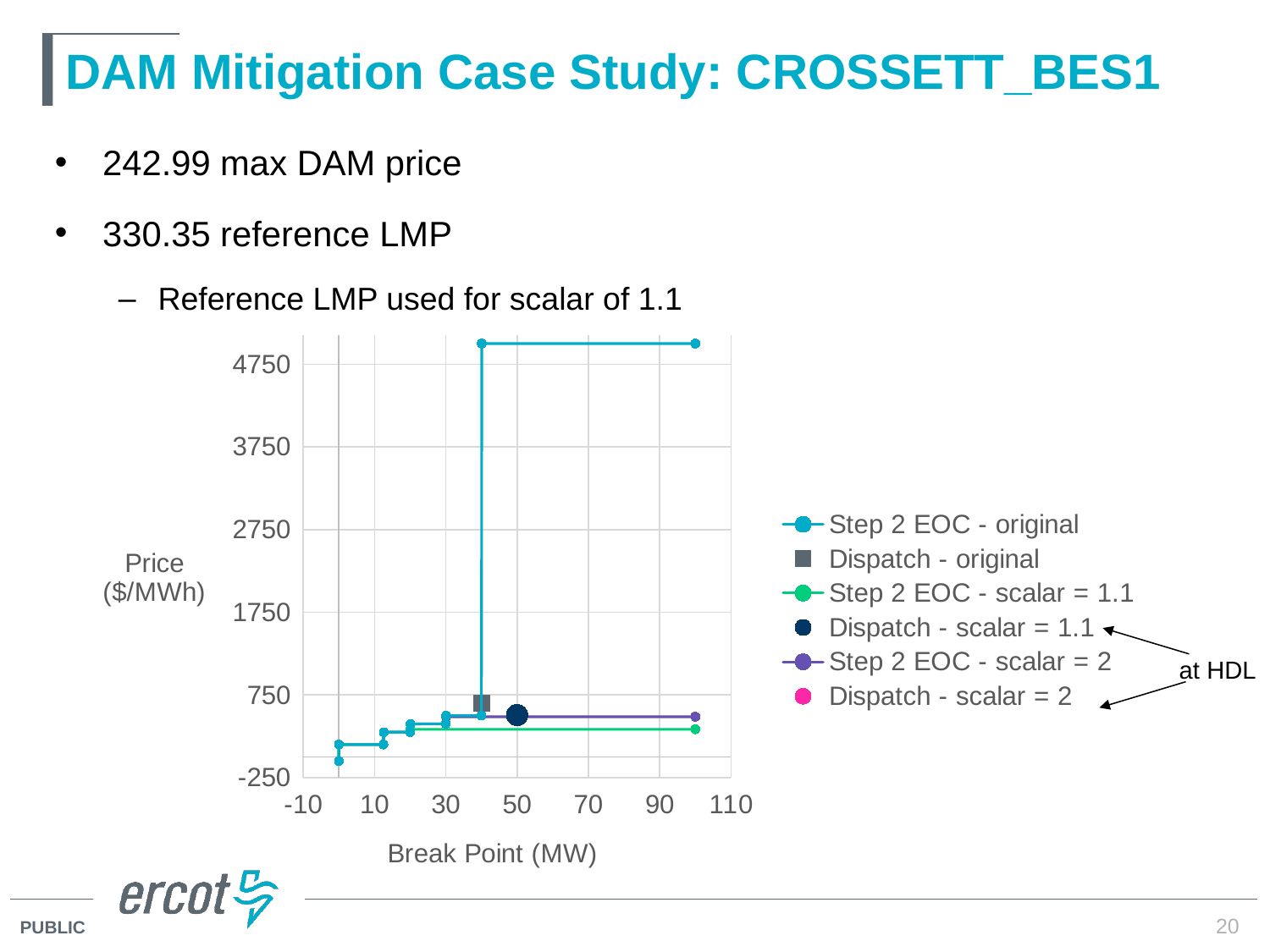
What is the title of the chart's horizontal axis? Break Point (MW) What kind of chart is shown on the slide? line chart Is the Dispatch - scalar = 1.1 point greater or less than 1750 $/MWh? less What is the title of the chart's vertical axis? Price ($/MWh) At a break point of 100 MW, which is higher: Step 2 EOC - scalar = 2 or Step 2 EOC - scalar = 1.1? Step 2 EOC - scalar = 2 How many series does the chart legend list? 6 Is the value of the Step 2 EOC - original series at a break point of 100 MW greater or less than 4750? greater Does the Step 2 EOC - original series rise or fall as the break point increases? rise Is the Step 2 EOC - original series at a break point of 0 MW greater or less than 750? less Which series reaches the highest price on the chart? Step 2 EOC - original